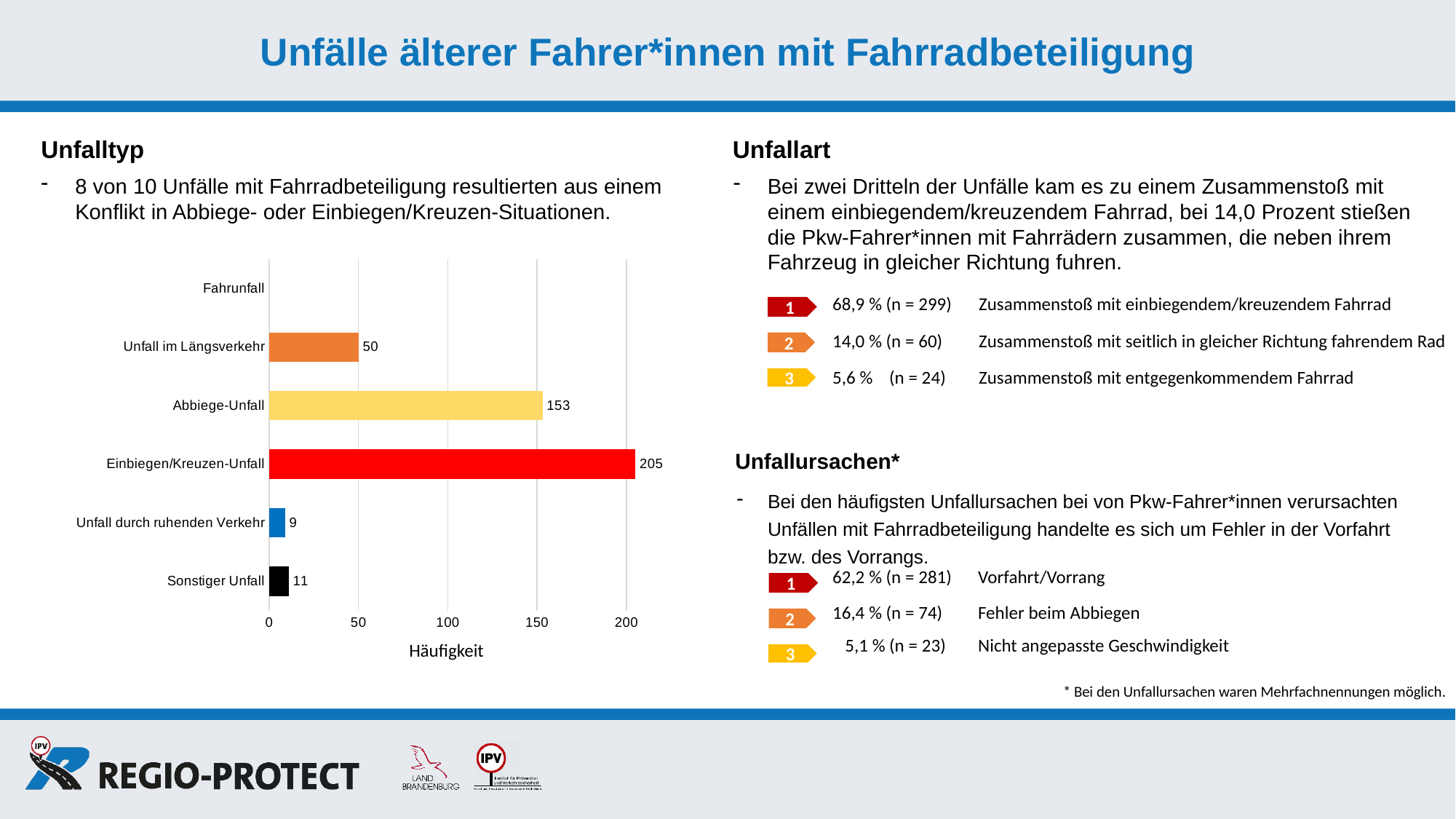
What is the value for Abbiege-Unfall in the chart? 153 What is the value for Einbiegen/Kreuzen-Unfall in the chart? 205 What kind of chart is shown on the slide? bar chart Which is larger: the value for Sonstiger Unfall or the value for Unfall durch ruhenden Verkehr? Sonstiger Unfall Which category with a plotted bar has the lowest value in the chart? Unfall durch ruhenden Verkehr What is the value for Unfall durch ruhenden Verkehr in the chart? 9 Which category has the highest value in the chart? Einbiegen/Kreuzen-Unfall What is the difference between the values for Einbiegen/Kreuzen-Unfall and Abbiege-Unfall? 52 Is the value for Abbiege-Unfall greater or less than 100? greater What is the label of the horizontal axis of the chart? Häufigkeit What is the value for Unfall im Längsverkehr in the chart? 50 How many categories are listed on the vertical axis of the chart? 6